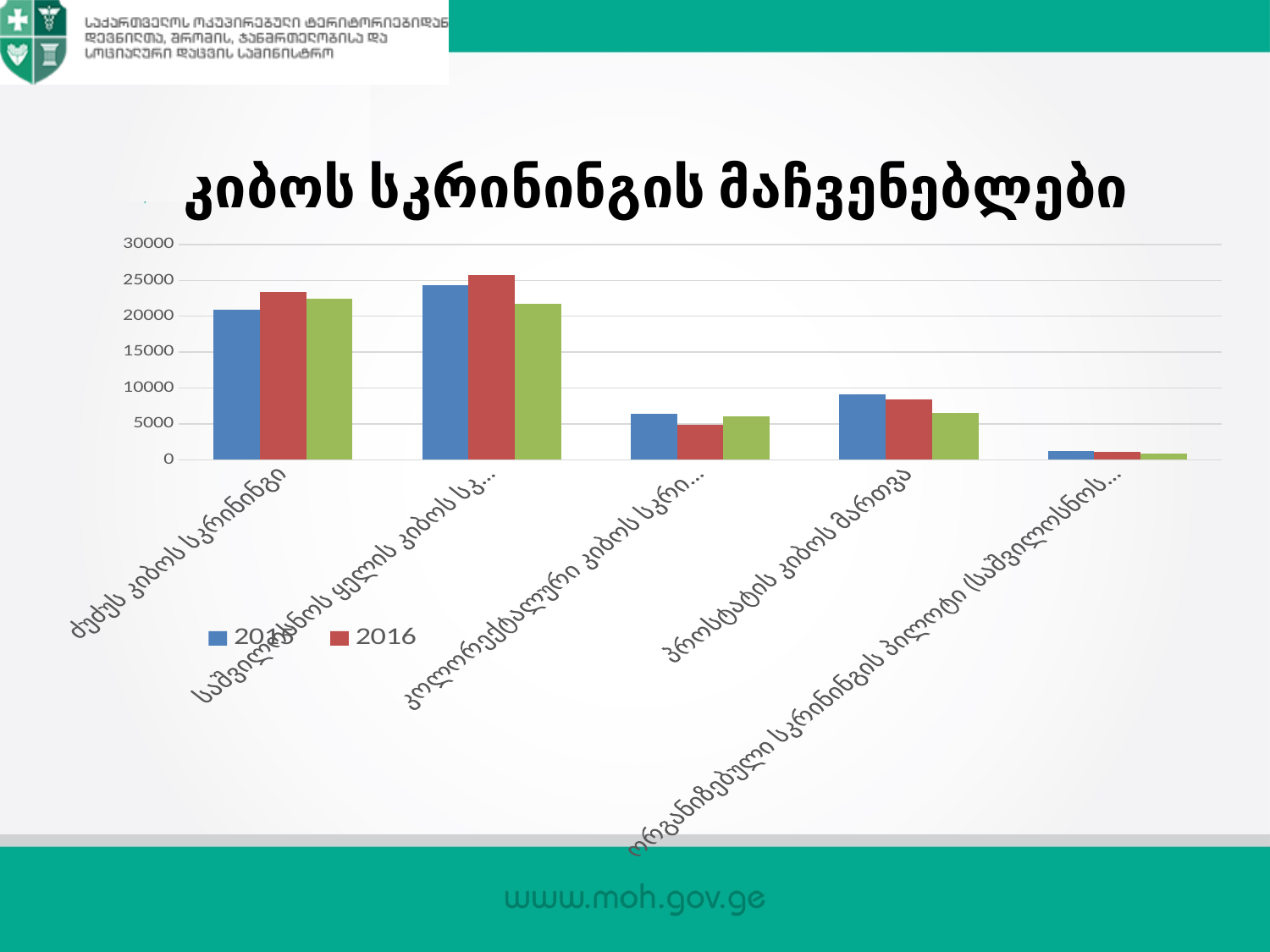
Is the 2015 value for პროსტატის კიბოს მართვა greater or less than 10000? less For ძუძუს კიბოს სკრინინგი, which series has the larger value, 2015 or 2016? 2016 Is the 2016 value for საშვილოსნოს ყელის კიბოს სკ... greater or less than 20000? greater How many categories are shown on the x axis of the chart? 5 What is the title of the chart? კიბოს სკრინინგის მაჩვენებლები For კოლორექტალური კიბოს სკრი..., which series has the larger value, 2015 or 2016? 2015 Is the 2016 value for კოლორექტალური კიბოს სკრი... greater or less than 10000? less Which category has the highest value for the 2016 series? საშვილოსნოს ყელის კიბოს სკ... What colour represents the 2016 series in the chart? red What kind of chart is shown on the slide? bar chart Which category has the lowest values across all series? ორგანიზებული სკრინინგის პილოტი (საშვილოსნოს...